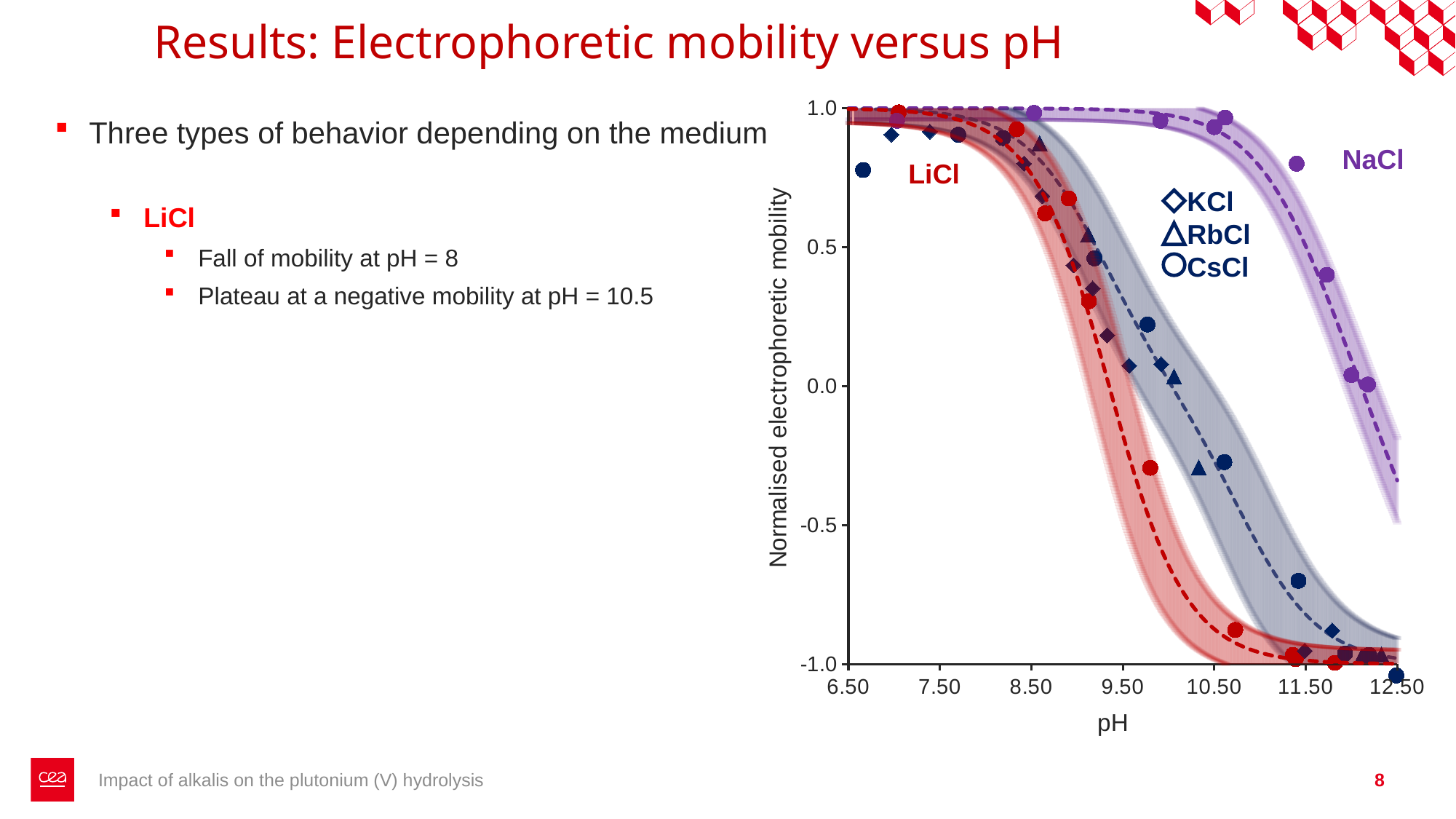
Which medium keeps its mobility near 1.0 up to the highest pH? NaCl Is the normalised mobility for LiCl at pH 7.50 greater or less than 0.5? greater What kind of chart is shown on the slide? Scatter plot with fitted curves Which medium shows the drop in mobility at the lowest pH? LiCl How many different media (series) are labelled on the chart? 5 Does the normalised electrophoretic mobility rise or fall as pH increases? Fall At pH 10.50, which medium has the higher normalised mobility, NaCl or LiCl? NaCl What is the highest pH value shown on the x axis? 12.50 What is the label of the y axis of the chart? Normalised electrophoretic mobility What is the label of the x axis of the chart? pH